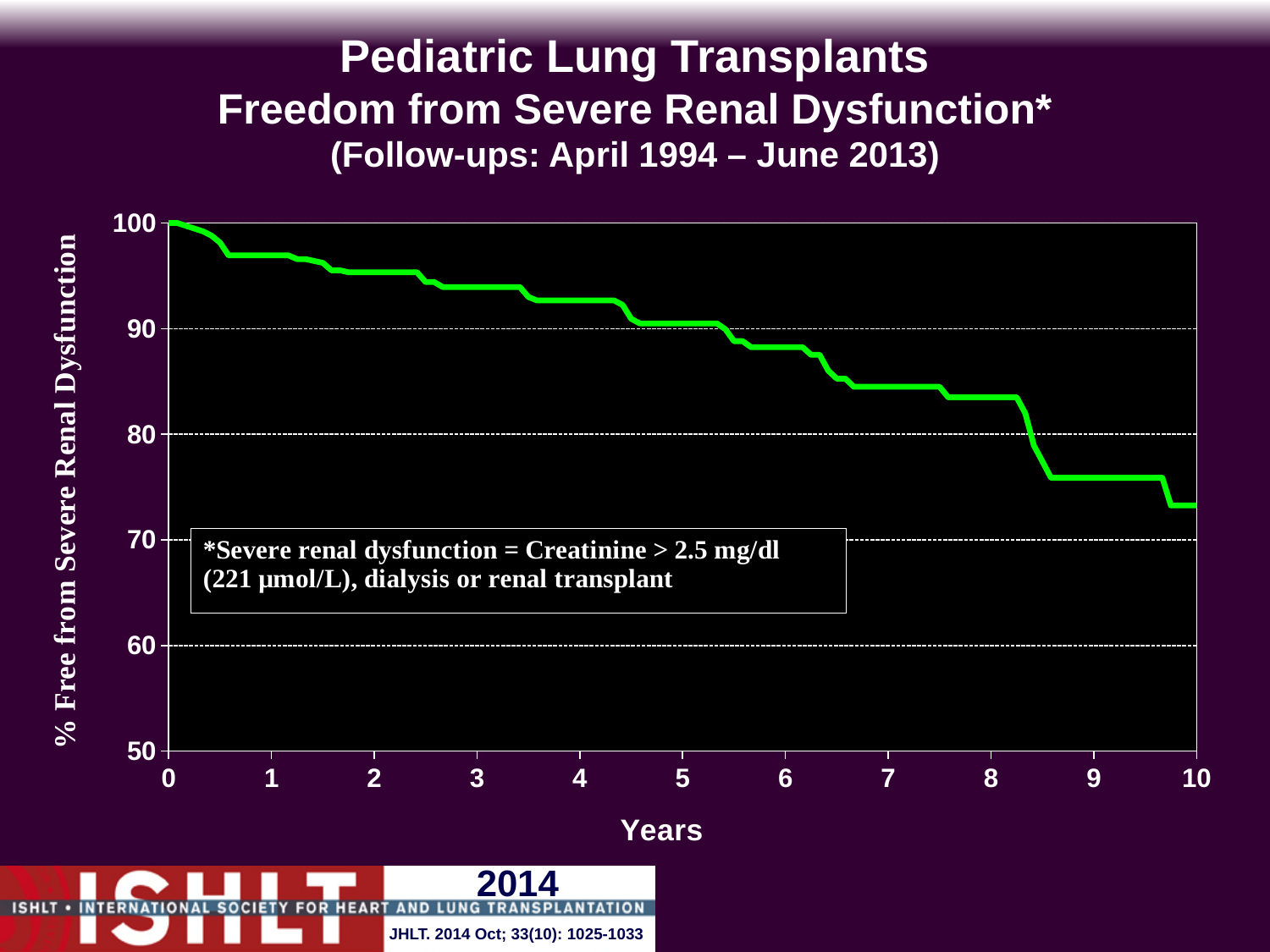
Is the value at year 6 greater or less than 90? less Does the plotted value rise or fall as the years increase along the x axis? fall What is the label of the x axis? Years What colour is the plotted line? green Is the value at year 2 greater or less than 90? greater At which year is the plotted value highest? 0 What kind of chart is shown on the slide? line chart What is the value of % Free from Severe Renal Dysfunction at year 0? 100 Is the value at year 9 greater or less than 80? less At which year is the plotted value lowest? 10